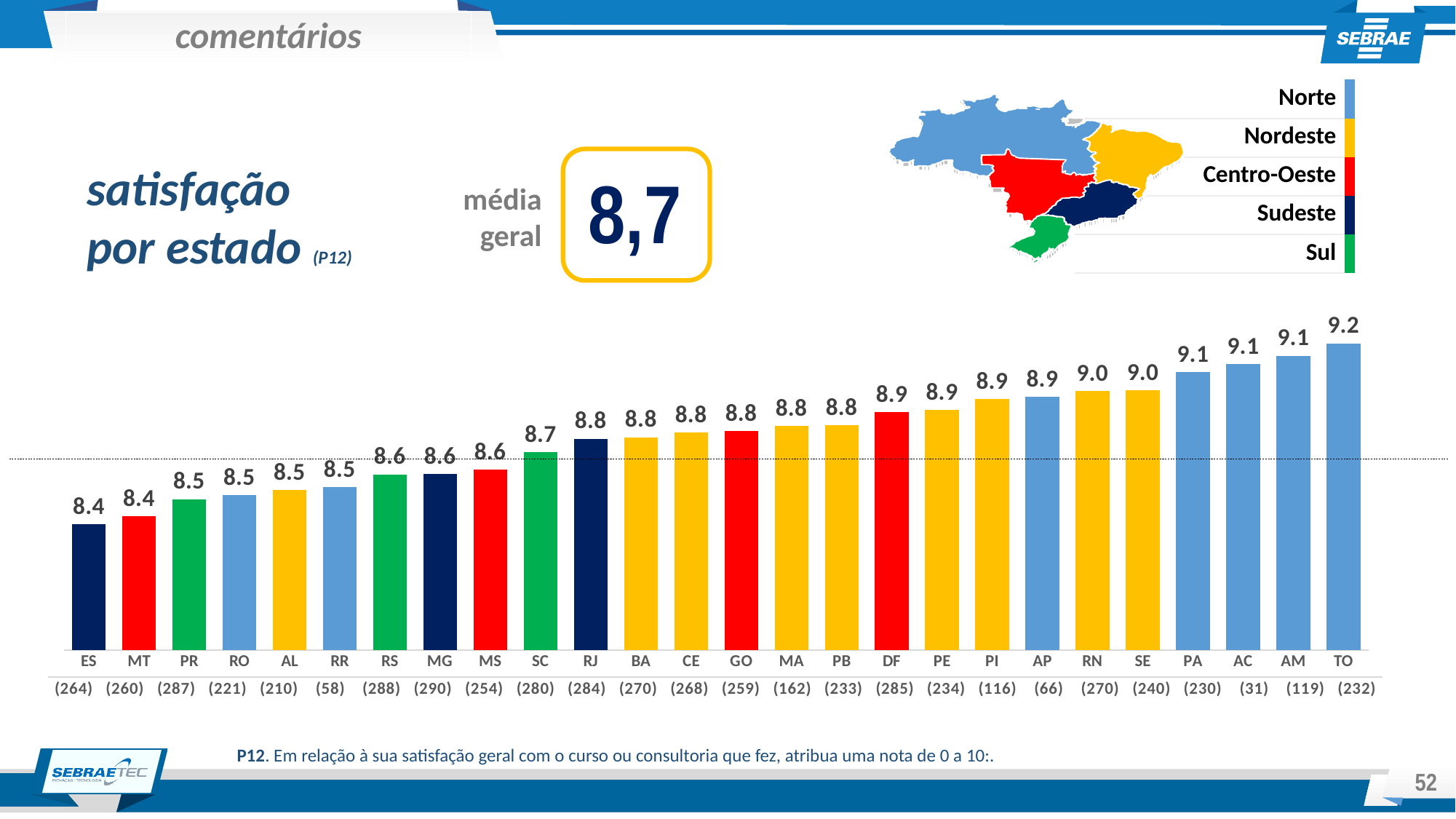
What kind of chart is shown on the slide? Bar chart What is the difference between the satisfaction scores of TO and ES? 0.8 Which state has the highest satisfaction score? TO How many regions does the legend list? 5 What is the satisfaction score for DF? 8.9 What is the difference between the satisfaction scores of PA and MG? 0.5 Do the satisfaction scores rise or fall from left to right along the x axis? Rise What is the satisfaction score for SC? 8.7 What is the satisfaction score for RN? 9.0 Which has a higher satisfaction score, AM or RS? AM What is the satisfaction score for TO? 9.2 How many states are shown in the chart? 26